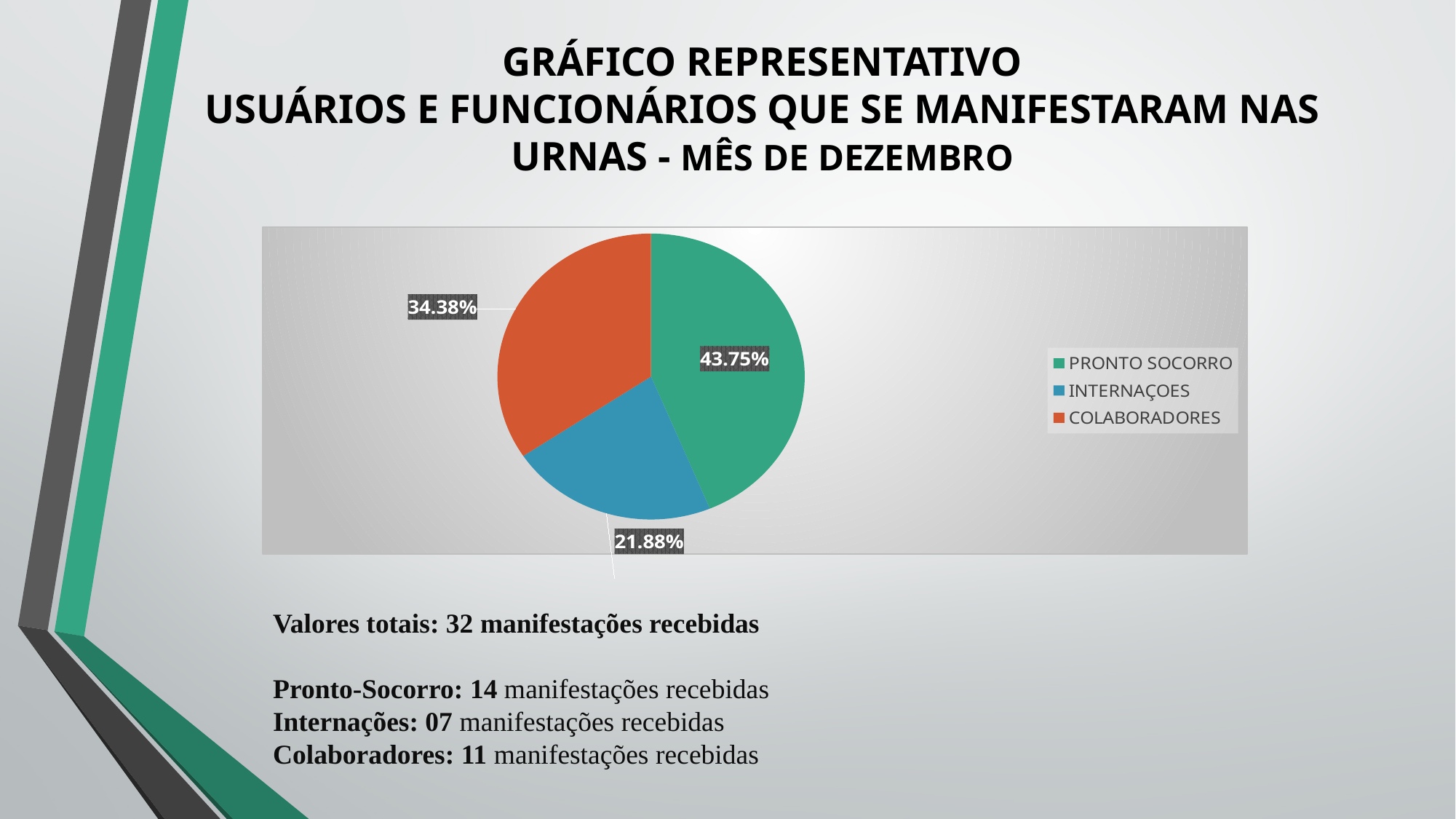
How many entries does the legend list? 3 Which category has the largest slice of the pie? PRONTO SOCORRO Which slice is larger, COLABORADORES or INTERNAÇOES? COLABORADORES What share of the pie does COLABORADORES represent? 34.38% What colour is the COLABORADORES slice? Orange How many slices does the pie chart have? 3 What is the difference in percentage points between the PRONTO SOCORRO slice and the INTERNAÇOES slice? 21.87 What share of the pie does INTERNAÇOES represent? 21.88% What kind of chart is shown on the slide? Pie chart What share of the pie does PRONTO SOCORRO represent? 43.75% Which category has the smallest slice of the pie? INTERNAÇOES What is the difference in percentage points between the COLABORADORES slice and the INTERNAÇOES slice? 12.5